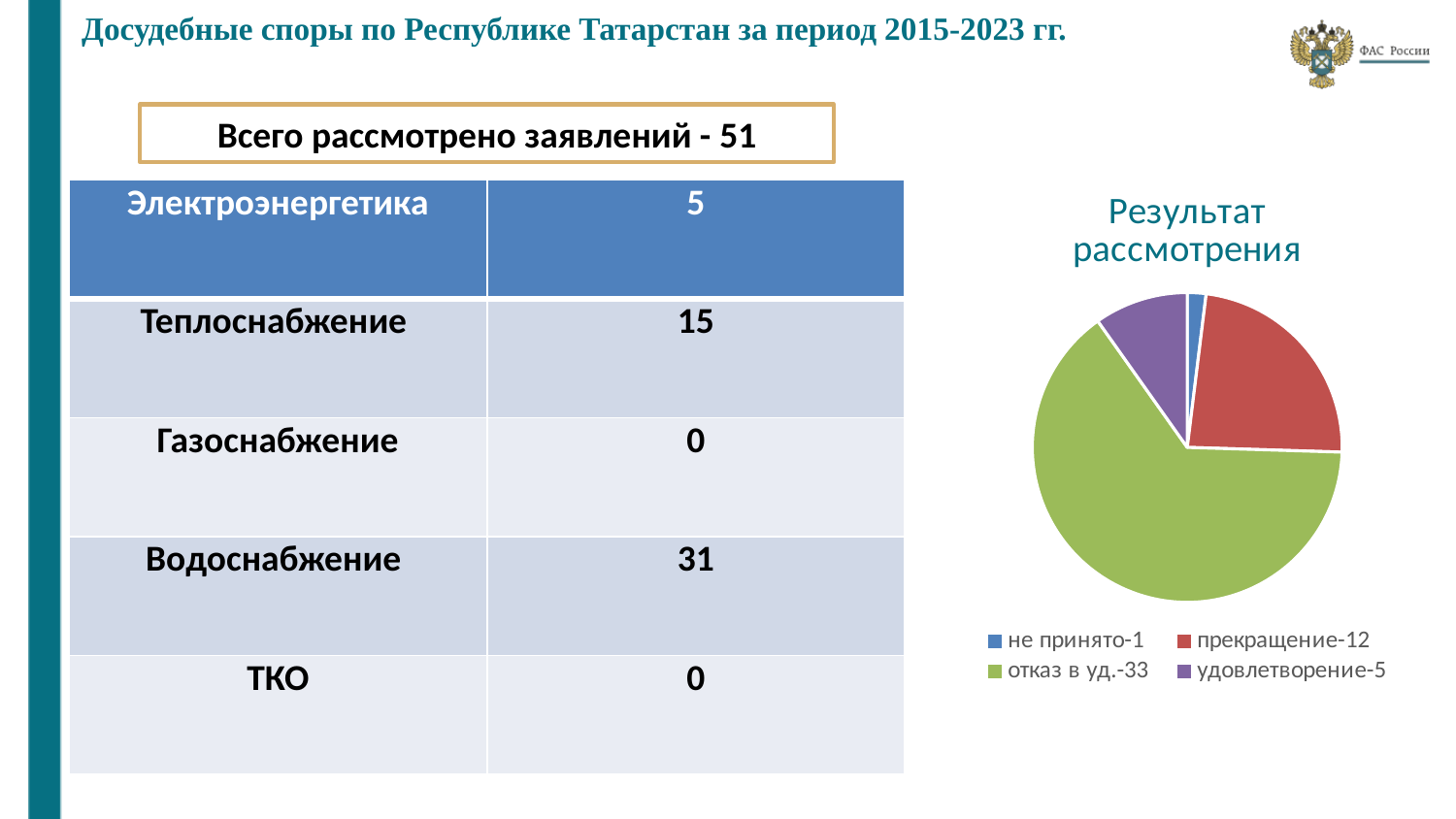
In the pie chart, what value is given for "прекращение"? 12 What kind of chart is shown under the title "Результат рассмотрения"? pie chart In the pie chart, what is the difference between the values for "отказ в уд." and "прекращение"? 21 Which category has the largest slice in the pie chart? отказ в уд.-33 How many categories does the legend of the pie chart list? 4 What is the title of the pie chart on the slide? Результат рассмотрения In the pie chart, what value is given for "отказ в уд."? 33 What colour is the slice for "отказ в уд." in the pie chart? green In the pie chart, which is larger: "прекращение" or "удовлетворение"? прекращение In the pie chart, what value is given for "не принято"? 1 Which category has the smallest slice in the pie chart? не принято-1 In the pie chart, what value is given for "удовлетворение"? 5